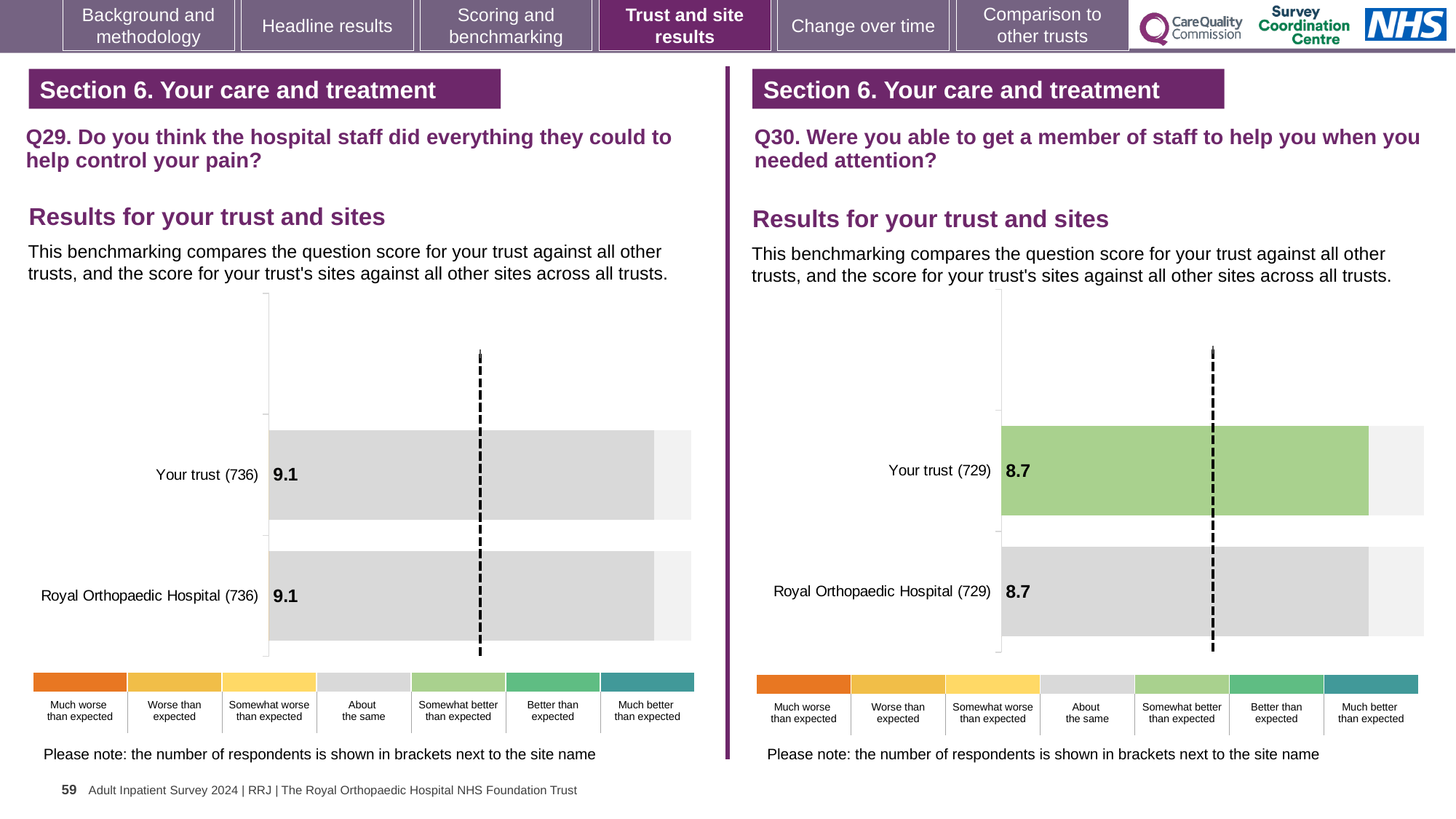
On the Q30 chart (right), which benchmark category does the green colour of the Your trust bar correspond to in the key? Somewhat better than expected On the Q30 chart (right), what is the difference between the score for Your trust and the score for Royal Orthopaedic Hospital? 0.0 On the Q29 chart (left), what is the score for Royal Orthopaedic Hospital? 9.1 What kind of chart is used on the Q30 chart (right)? Bar chart On the Q30 chart (right), what is the score for Your trust? 8.7 On the Q29 chart (left), how many respondents are shown in brackets next to Your trust? 736 How many bars are plotted on the Q30 chart (right)? 2 On the Q29 chart (left), what is the score for Your trust? 9.1 On the Q30 chart (right), how many respondents are shown in brackets next to Royal Orthopaedic Hospital? 729 How many bars are plotted on the Q29 chart (left)? 2 On the Q30 chart (right), what is the score for Royal Orthopaedic Hospital? 8.7 On the Q29 chart (left), what is the difference between the score for Your trust and the score for Royal Orthopaedic Hospital? 0.0